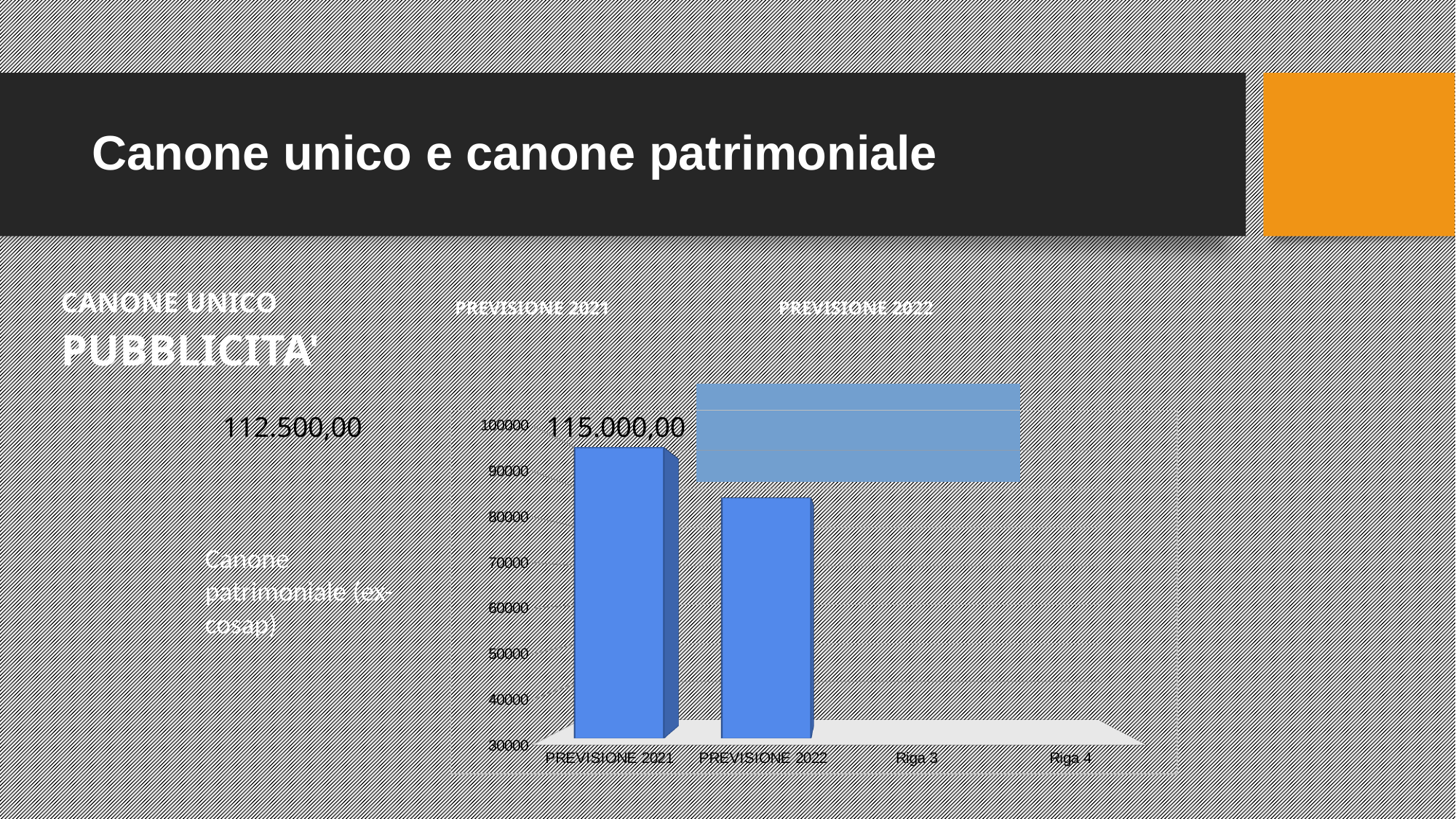
Is the bar for PREVISIONE 2021 larger or smaller than the bar for PREVISIONE 2022? larger Is the value for PREVISIONE 2021 greater or less than 90000? greater What is the highest value shown on the chart's vertical axis? 100000 Which category has the tallest bar in the chart? PREVISIONE 2021 Is the value for PREVISIONE 2022 greater or less than 80000? greater Is the value for PREVISIONE 2022 greater or less than 90000? less How many category labels are shown on the x axis of the chart? 4 What kind of chart is shown on the slide? bar chart Do the bar values rise or fall from PREVISIONE 2021 to PREVISIONE 2022? fall Which of the two plotted bars is shorter, PREVISIONE 2021 or PREVISIONE 2022? PREVISIONE 2022 What is the lowest value shown on the chart's vertical axis? 30000